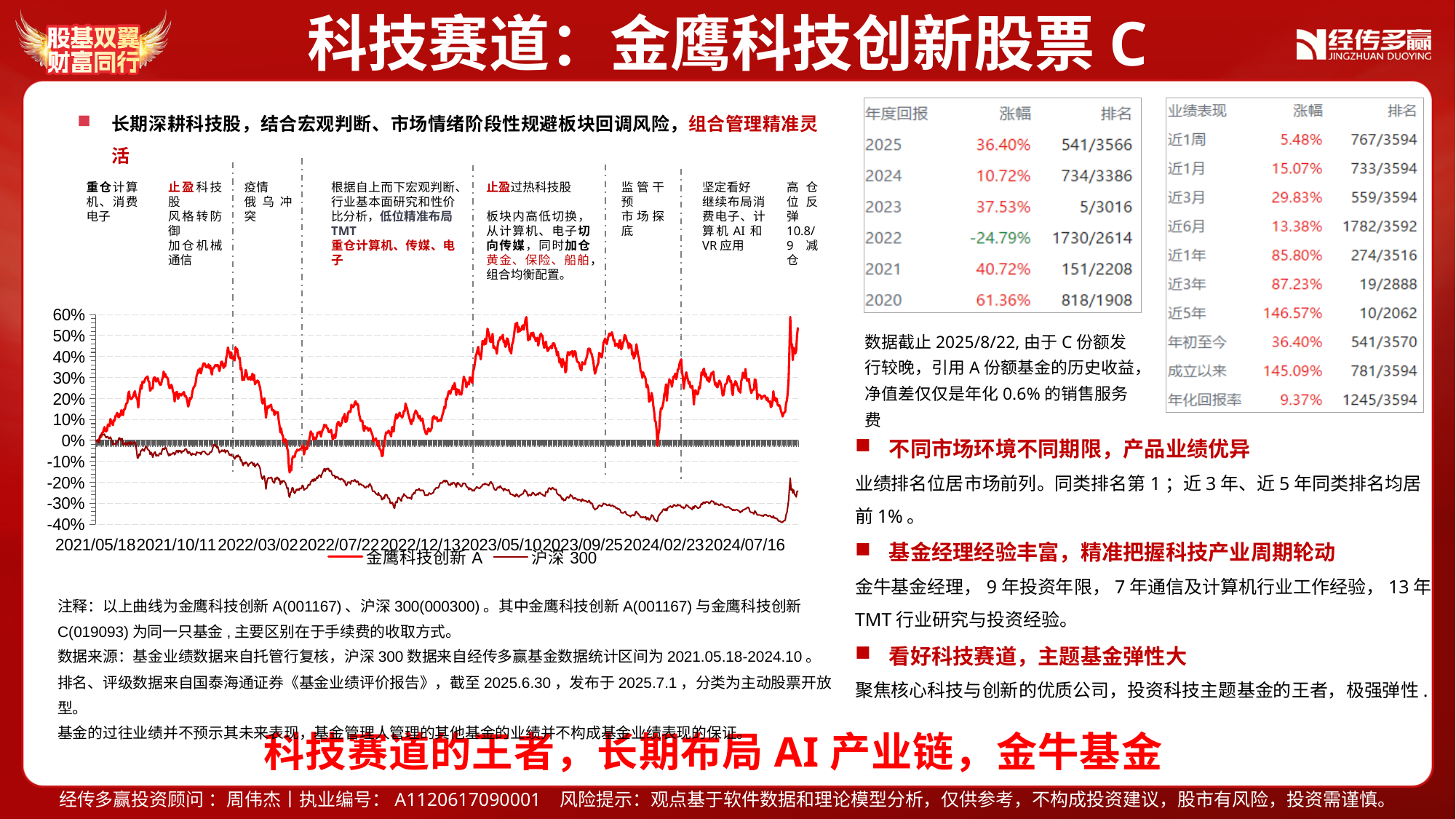
How many date labels are shown along the x axis of the line chart? 9 Over the whole period shown in the line chart, does the 沪深 300 line rise or fall overall? fall At the right end of the line chart, which series is higher, 金鹰科技创新 A or 沪深 300? 金鹰科技创新 A What are the two series named in the legend of the line chart? 金鹰科技创新 A and 沪深 300 At the right end of the line chart, is the value for 金鹰科技创新 A greater or less than 40%? greater What kind of chart is shown on the left of the slide? line chart How many series does the legend of the line chart list? 2 What is the highest value shown on the y axis of the line chart? 60% Over the whole period shown in the line chart, does the 金鹰科技创新 A line rise or fall overall? rise At the right end of the line chart, is the value for 沪深 300 greater or less than 0%? less What is the first date label on the x axis of the line chart? 2021/05/18 Around 2024/02/23, is the value for 沪深 300 greater or less than -20%? less